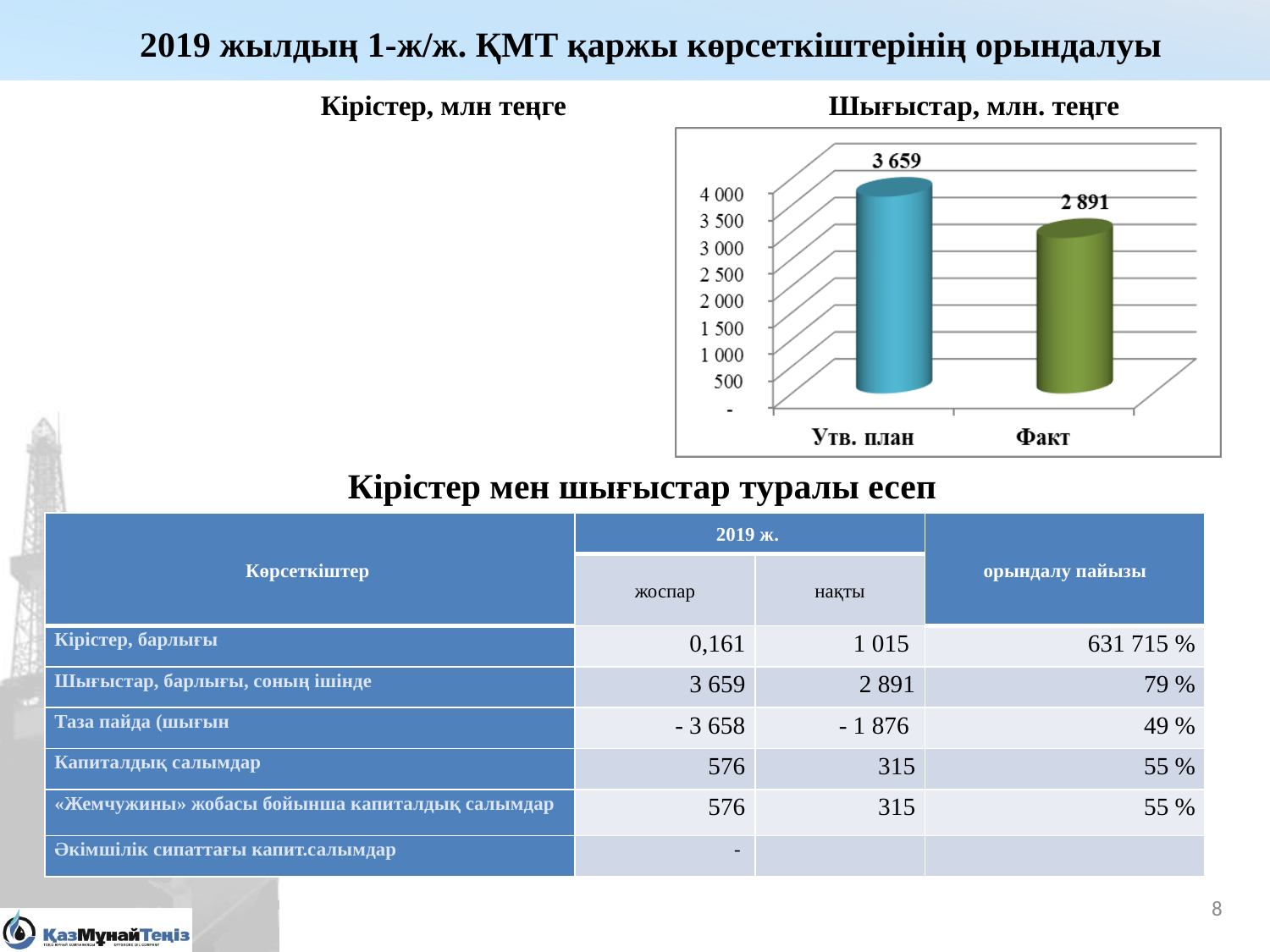
In the chart titled "Шығыстар, млн. теңге", what colour is the Факт bar? green In the chart titled "Шығыстар, млн. теңге", which category has the highest value? Утв. план How many bars are plotted in the chart titled "Шығыстар, млн. теңге"? 2 In the chart titled "Шығыстар, млн. теңге", which category has the lowest value? Факт In the chart titled "Шығыстар, млн. теңге", what is the value for Факт? 2 891 In the chart titled "Шығыстар, млн. теңге", is the value for Утв. план greater or less than 3 500? greater In the chart titled "Шығыстар, млн. теңге", what is the value for Утв. план? 3 659 In the chart titled "Шығыстар, млн. теңге", what is the difference between the Утв. план value and the Факт value? 768 In the chart titled "Шығыстар, млн. теңге", do the values rise or fall from Утв. план to Факт? fall What kind of chart is the one titled "Шығыстар, млн. теңге"? bar chart In the chart titled "Шығыстар, млн. теңге", is the value for Факт greater or less than 3 000? less In the chart titled "Шығыстар, млн. теңге", which is larger, Утв. план or Факт? Утв. план